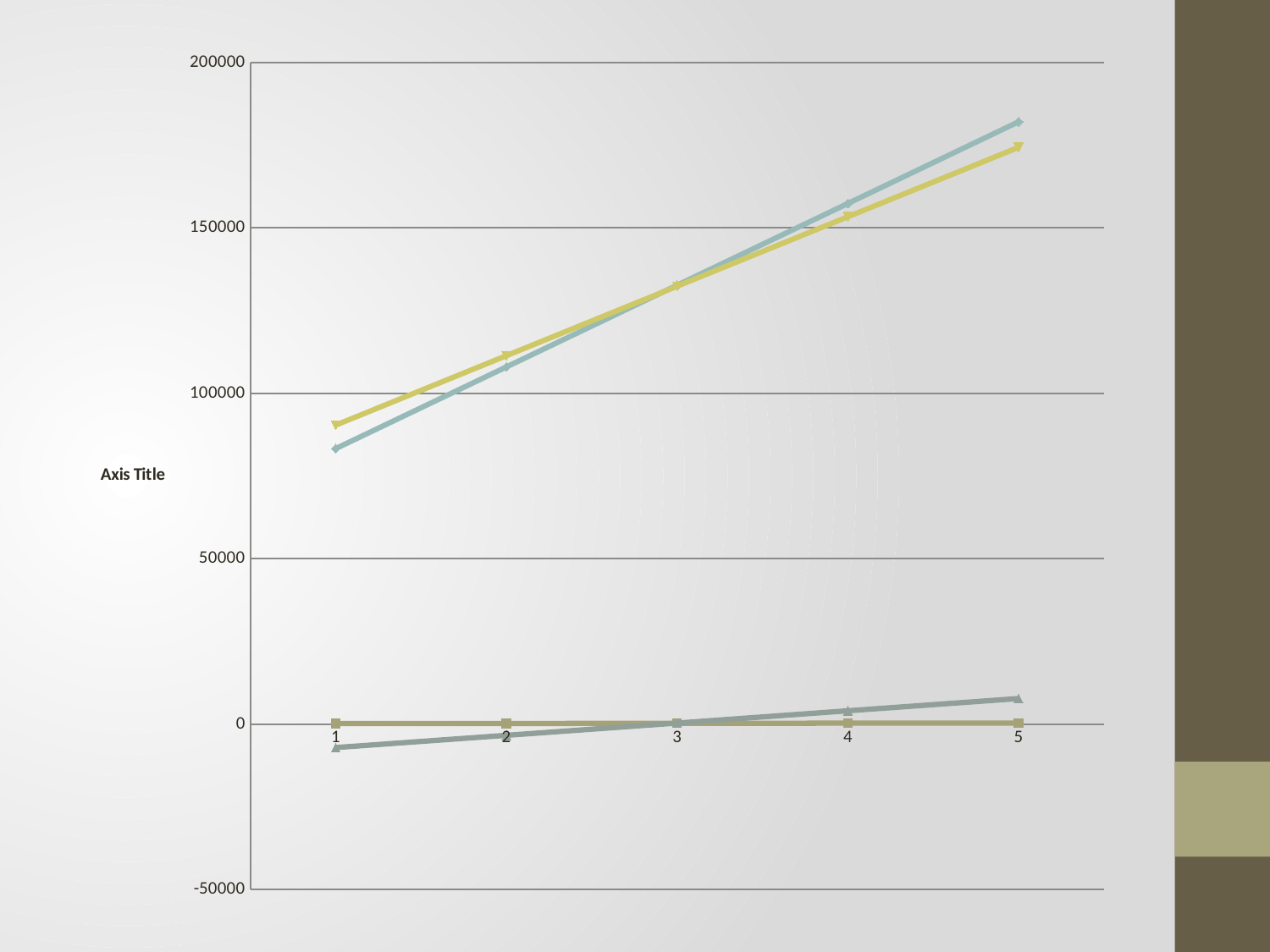
How many points are labelled along the x axis of the chart? 5 Is the value of the blue diamond line at x = 5 greater or less than 150000? greater Is the value of the grey-green triangle line at x = 1 greater or less than 0? less At x = 1, which line is higher: the blue diamond line or the yellow triangle line? the yellow triangle line At x = 5, which line is higher: the blue diamond line or the yellow triangle line? the blue diamond line What is the title shown on the vertical axis of the chart? Axis Title Is the value of the yellow triangle line at x = 2 greater or less than 100000? greater Does the blue line with diamond markers rise or fall from x = 1 to x = 5? rise What kind of chart is shown on the slide? line chart Does the yellow line with triangle markers rise or fall from x = 1 to x = 5? rise